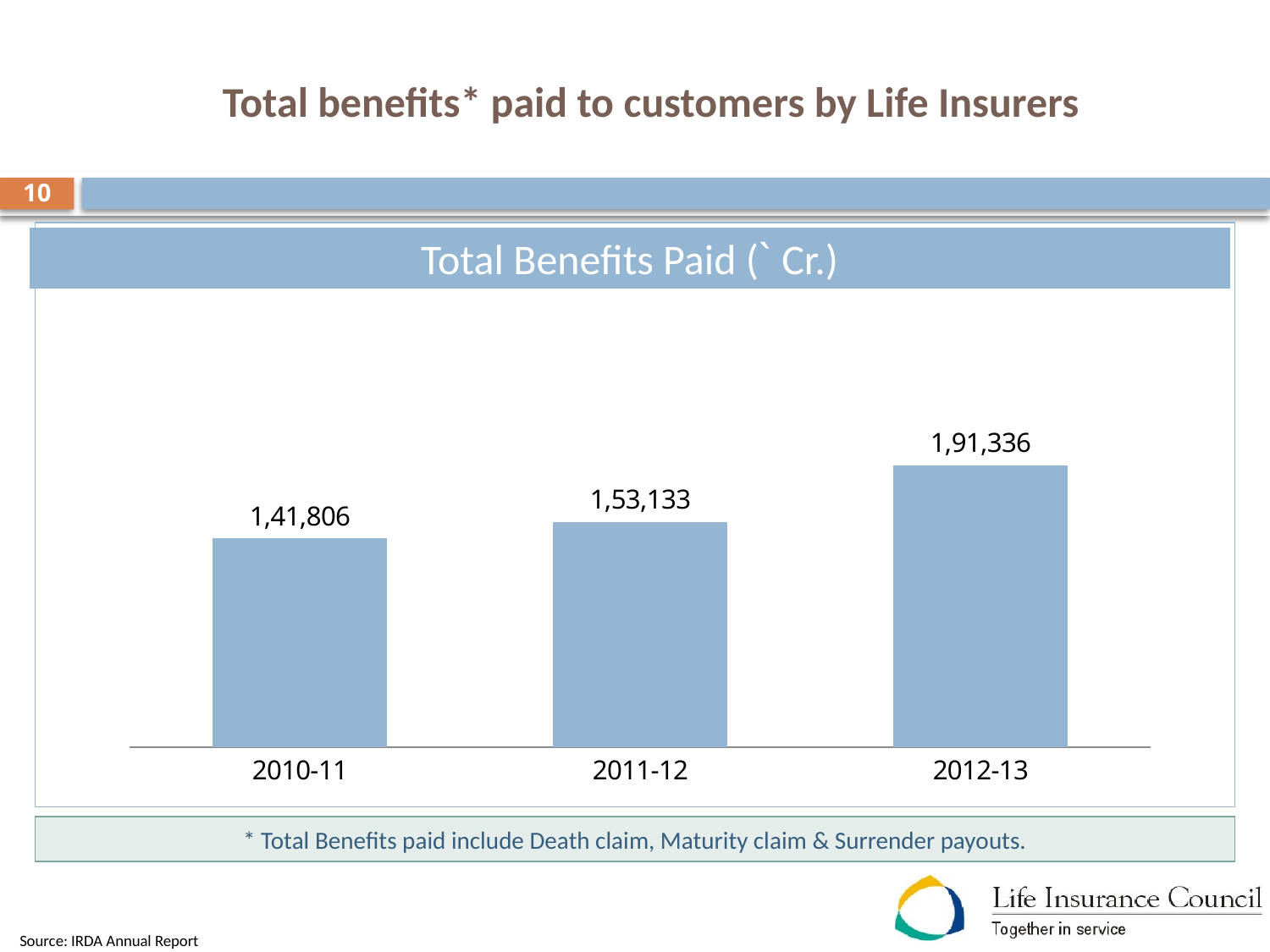
What is the difference between the values for 2012-13 and 2010-11? 49,530 Which year has the highest total benefits paid? 2012-13 What is the difference between the values for 2011-12 and 2010-11? 11,327 Which year has the lowest total benefits paid? 2010-11 Do the values rise or fall from 2010-11 to 2012-13? Rise What kind of chart is shown on the slide? Bar chart What is the value for 2012-13? 1,91,336 What is the value for 2011-12? 1,53,133 Which is larger, the value for 2011-12 or the value for 2012-13? 2012-13 What is the difference between the values for 2012-13 and 2011-12? 38,203 What is the value for 2010-11? 1,41,806 How many years are shown on the chart? 3